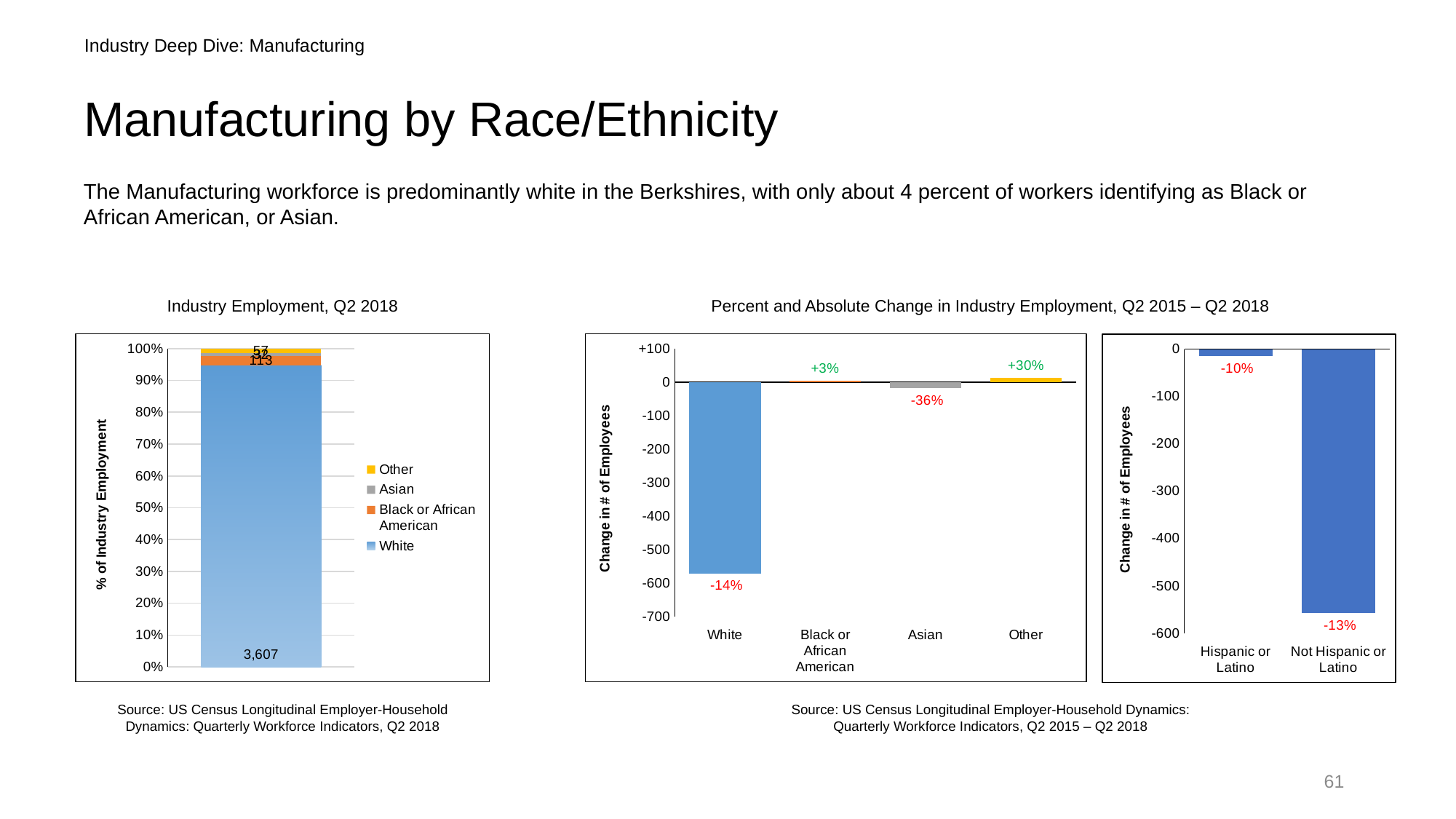
How many categories are shown on the x axis of the middle chart (Percent and Absolute Change in Industry Employment by race)? 4 In the 'Industry Employment, Q2 2018' chart, what is the data label shown for the Black or African American segment? 113 In the middle chart (Percent and Absolute Change in Industry Employment by race), what percent change is labeled for White? -14% In the middle chart (Percent and Absolute Change in Industry Employment by race), is the change in number of employees for White greater or less than -500? less How many series does the legend of the 'Industry Employment, Q2 2018' chart list? 4 In the middle chart (Percent and Absolute Change in Industry Employment by race), what percent change is labeled for Other? +30% In the middle chart (Percent and Absolute Change in Industry Employment by race), what percent change is labeled for Asian? -36% In the rightmost chart (change in employment by Hispanic or Latino status), is the change in number of employees for Not Hispanic or Latino greater or less than -500? less In the rightmost chart (change in employment by Hispanic or Latino status), what percent change is labeled for Not Hispanic or Latino? -13% In the 'Industry Employment, Q2 2018' chart, what is the data label shown for the White segment? 3,607 What kind of chart is the 'Industry Employment, Q2 2018' chart? Stacked bar chart In the middle chart (Percent and Absolute Change in Industry Employment by race), which category has the largest decrease in number of employees? White